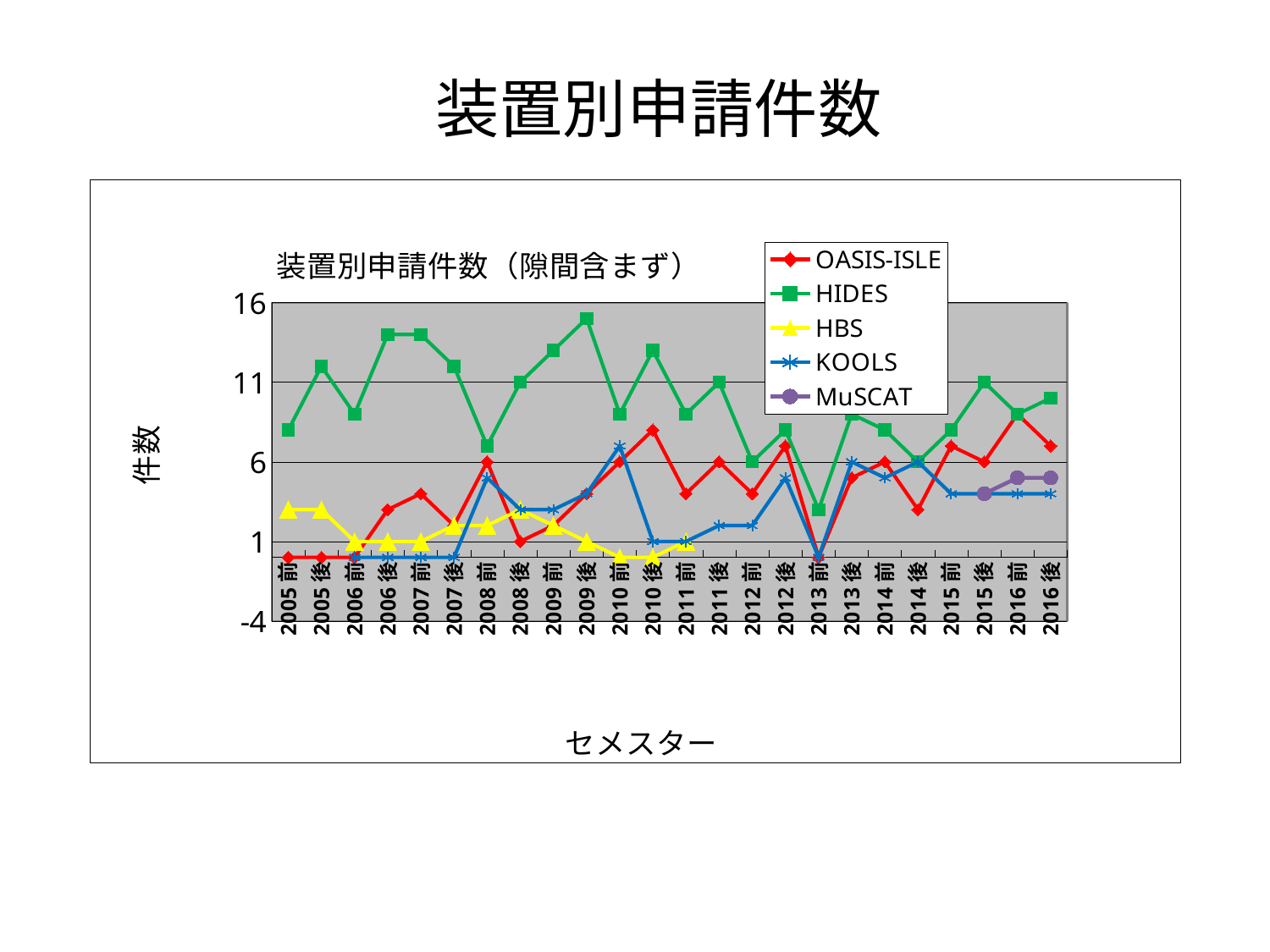
Which is larger at 2005後, the value for HIDES or the value for OASIS-ISLE? HIDES Is the value for HIDES at 2009後 greater or less than 11? greater How many series does the legend list? 5 In which semester does HIDES reach its highest value? 2009後 Does the HIDES line rise or fall from 2012後 to 2013前? fall Which series has the highest value at 2009後? HIDES What is the label on the x axis of the chart? セメスター Is the value for HIDES at 2013前 greater or less than 6? less How many semesters are plotted along the x axis? 24 What kind of chart is shown on the slide? line chart Is the value for OASIS-ISLE at 2010後 greater or less than 6? greater In which semester does HIDES reach its lowest value? 2013前